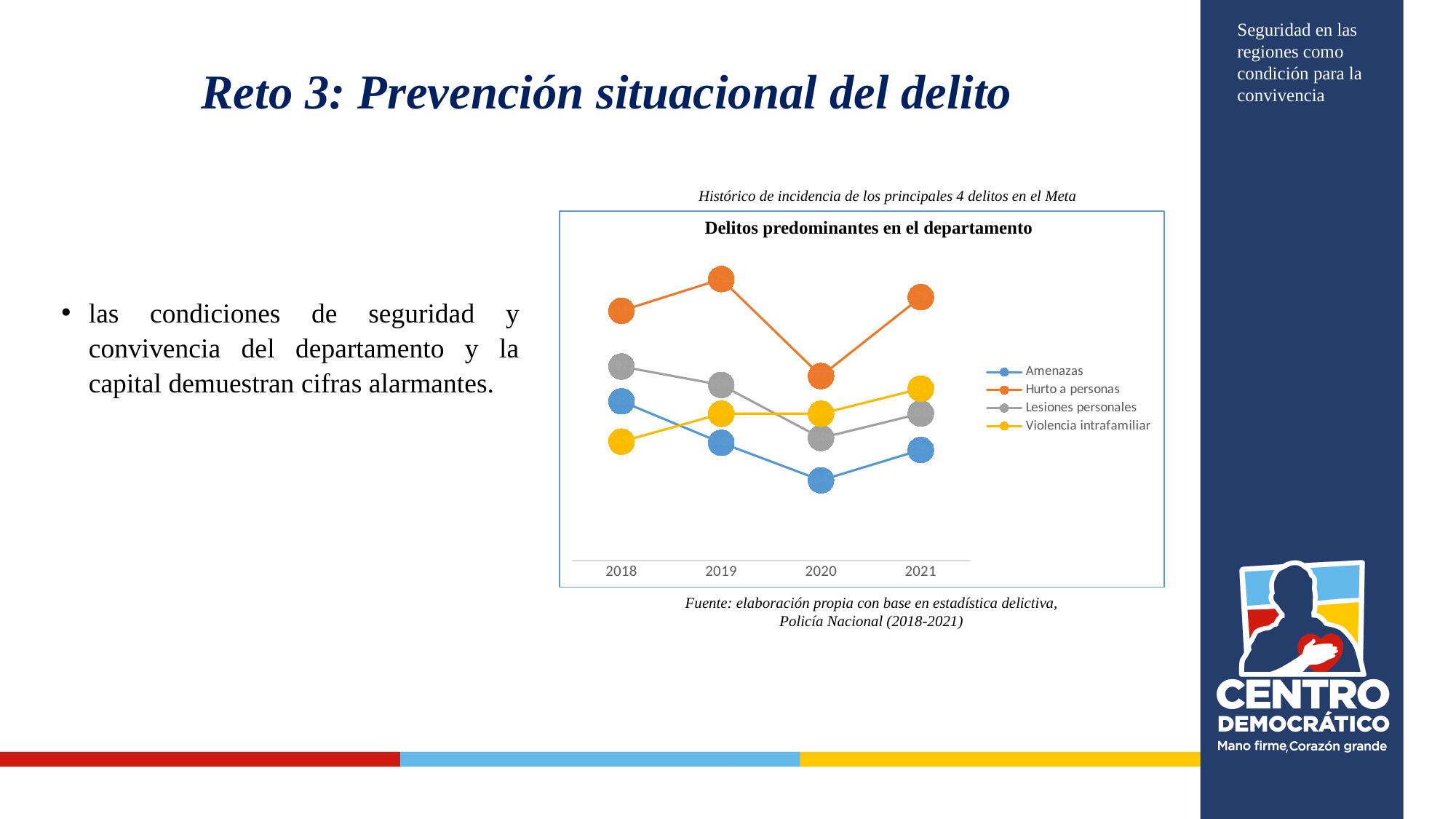
How many series does the legend of the chart list? 4 What kind of chart is shown on the slide? line chart Which series has the lowest value in 2020? Amenazas How many years are shown on the x axis of the chart? 4 In 2021, which is higher: Violencia intrafamiliar or Lesiones personales? Violencia intrafamiliar In which year does Hurto a personas reach its highest point? 2019 Does the Violencia intrafamiliar series rise or fall from 2018 to 2021? rise What is the title of the chart? Delitos predominantes en el departamento In which year does Hurto a personas reach its lowest point? 2020 Which series has the lowest value in 2018? Violencia intrafamiliar In 2018, which is higher: Lesiones personales or Amenazas? Lesiones personales Which series has the highest values in every year shown? Hurto a personas